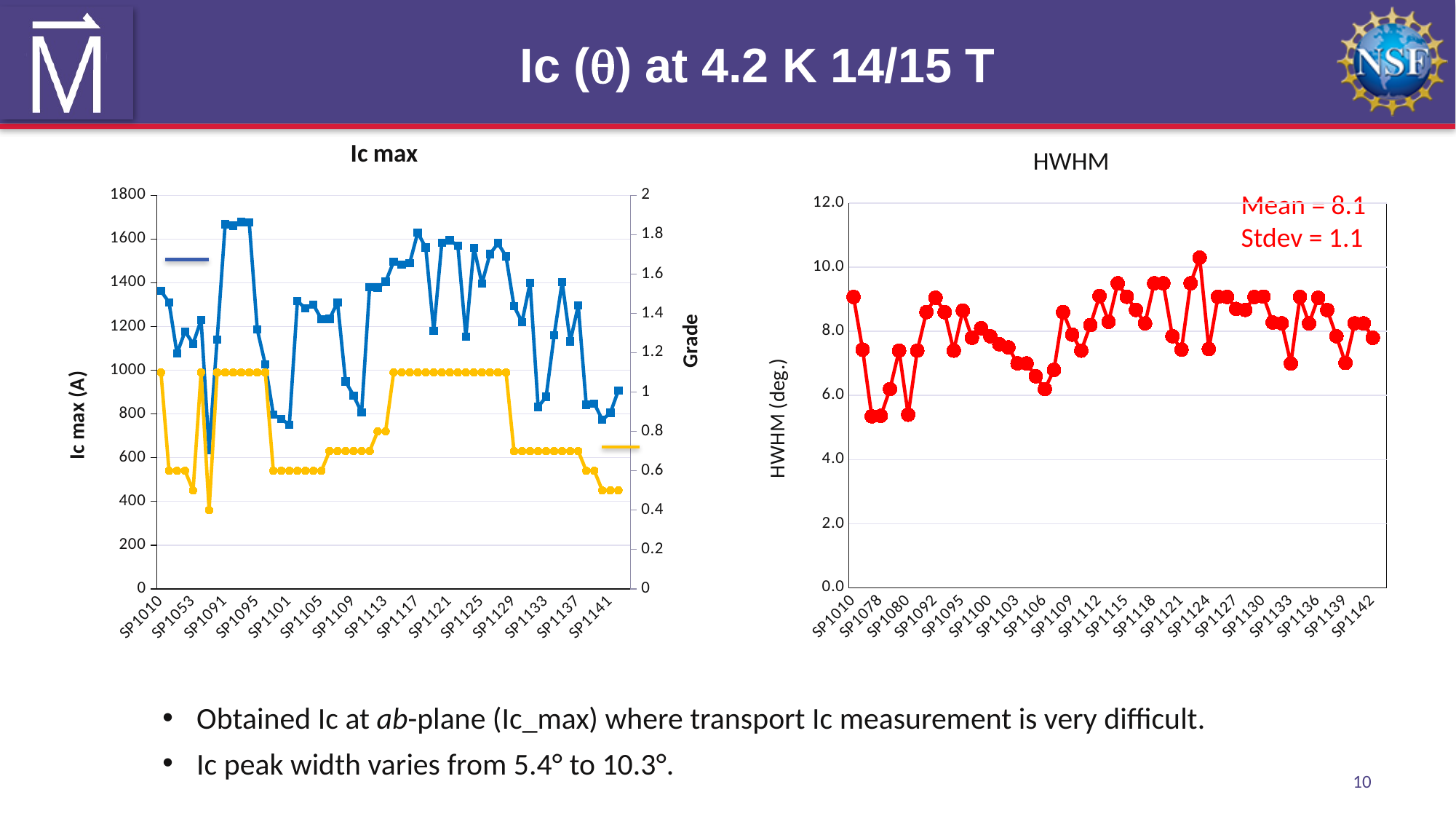
What kind of chart is the Ic max chart on the left? line chart On the HWHM chart, what standard deviation (Stdev) is printed on the chart? 1.1 What is the title of the chart on the left? Ic max On the HWHM chart, is the HWHM value for SP1010 greater or less than 8.0? greater On the Ic max chart, which has the larger Ic max value, SP1010 or SP1141? SP1010 On the Ic max chart, is the Ic max value for SP1010 greater or less than 1200? greater On the HWHM chart, is the HWHM value for SP1142 greater or less than 10.0? less What is the label of the right-hand vertical axis on the Ic max chart? Grade On the HWHM chart, what mean value is printed on the chart? 8.1 What kind of chart is the HWHM chart on the right? line chart